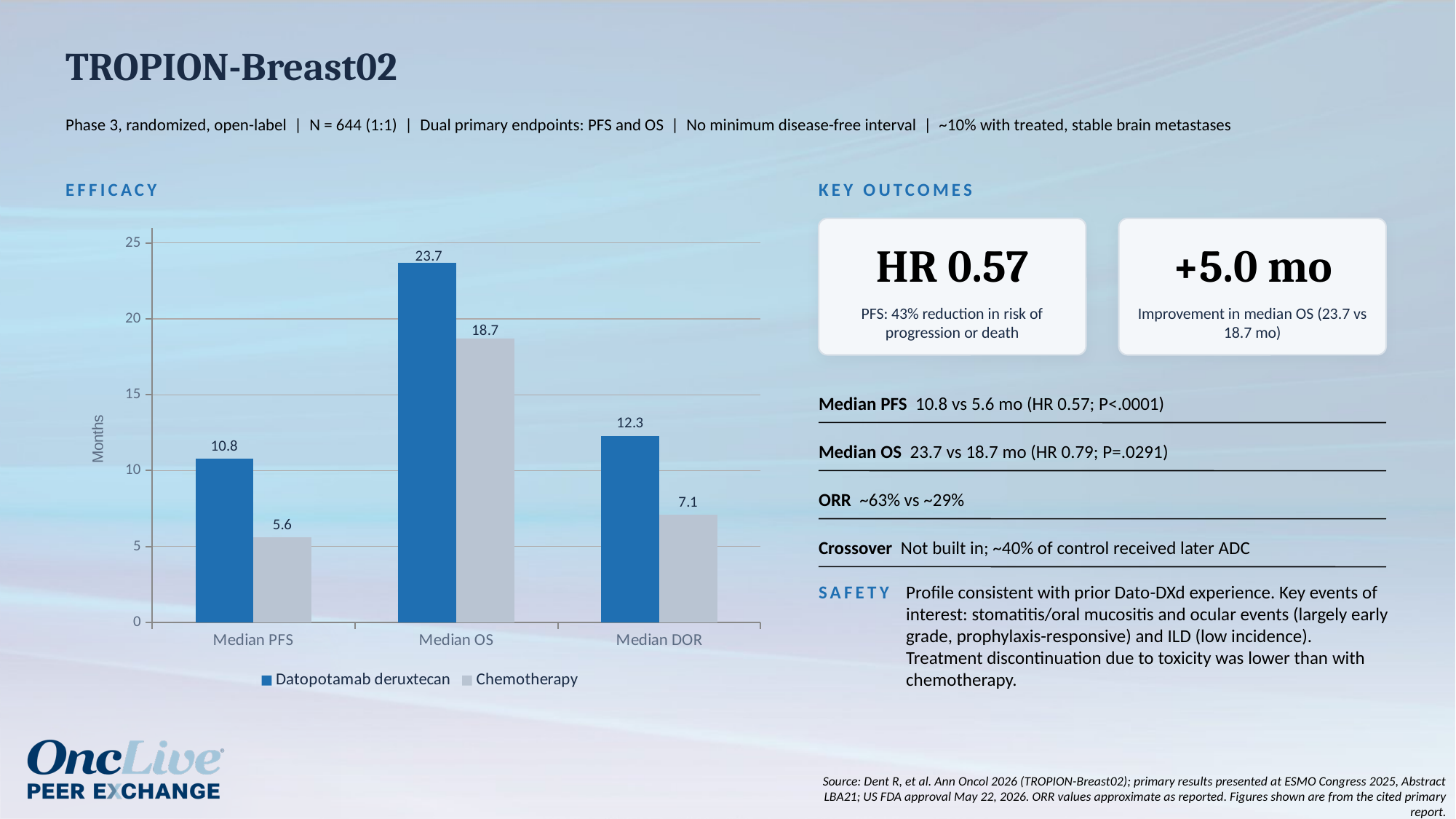
What is the median PFS value for Datopotamab deruxtecan in the chart? 10.8 What is the difference between the Datopotamab deruxtecan and Chemotherapy values for Median OS? 5.0 Is the Chemotherapy value for Median DOR greater or less than 10? less Which is larger for Median DOR: Datopotamab deruxtecan or Chemotherapy? Datopotamab deruxtecan What is the median DOR value for Datopotamab deruxtecan in the chart? 12.3 Which category has the lowest value for Chemotherapy? Median PFS Which category has the highest value for Datopotamab deruxtecan? Median OS What is the median OS value for Chemotherapy in the chart? 18.7 What type of chart is shown on the slide? Bar chart How many categories are shown on the x axis of the chart? 3 How many series does the chart legend list? 2 What is the difference between the Datopotamab deruxtecan and Chemotherapy values for Median PFS? 5.2